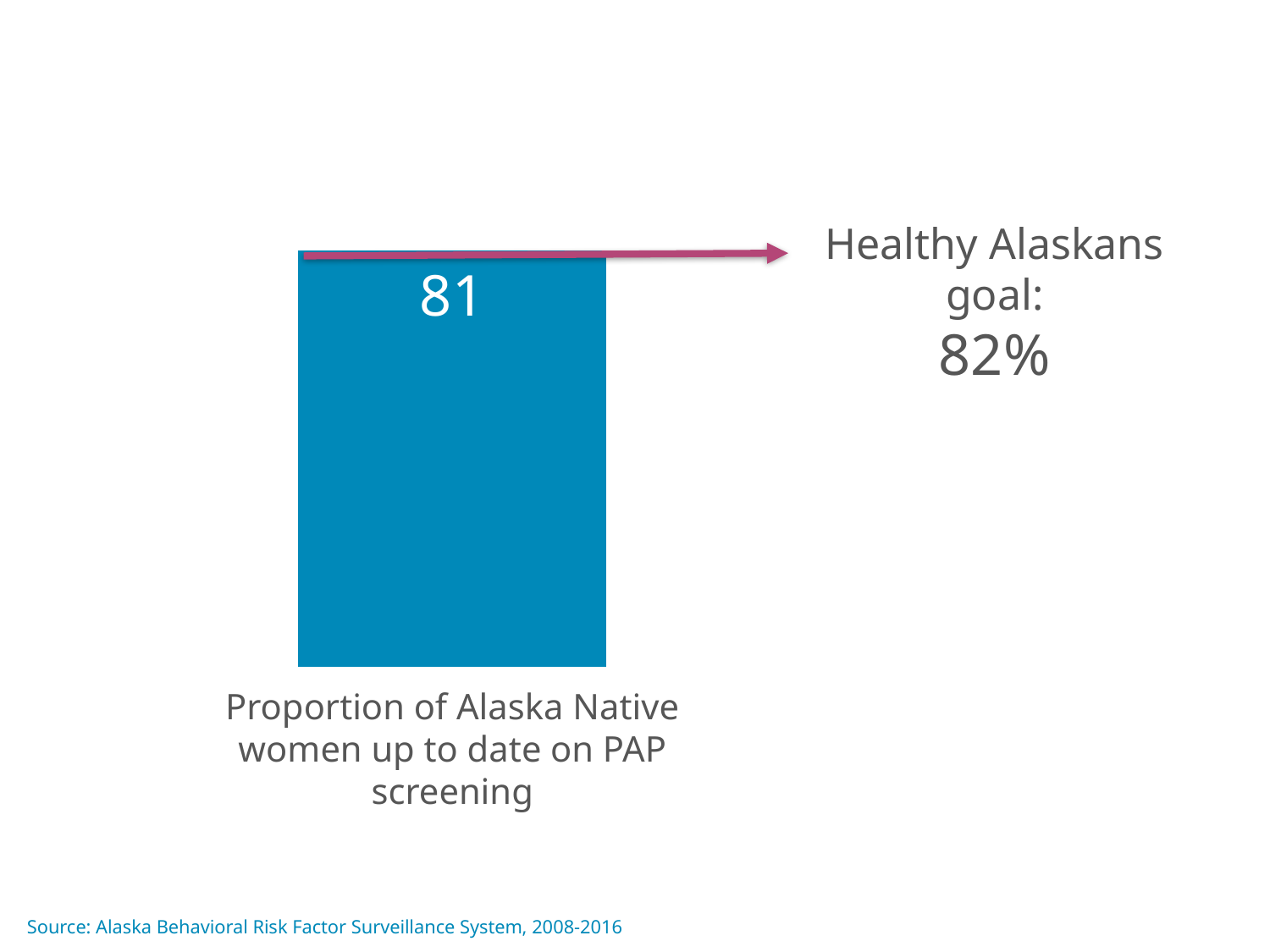
What is the category label under the bar? Proportion of Alaska Native women up to date on PAP screening What is the value shown on the bar for the proportion of Alaska Native women up to date on PAP screening? 81 Which is larger: the plotted value for Alaska Native women up to date on PAP screening or the Healthy Alaskans goal? the Healthy Alaskans goal What kind of chart is shown on the slide? bar chart What is the Healthy Alaskans goal shown next to the chart? 82% Is the value for the proportion of Alaska Native women up to date on PAP screening greater or less than 82? less By how many percentage points does the plotted value of 81 fall short of the Healthy Alaskans goal of 82%? 1 How many bars are plotted in the chart? 1